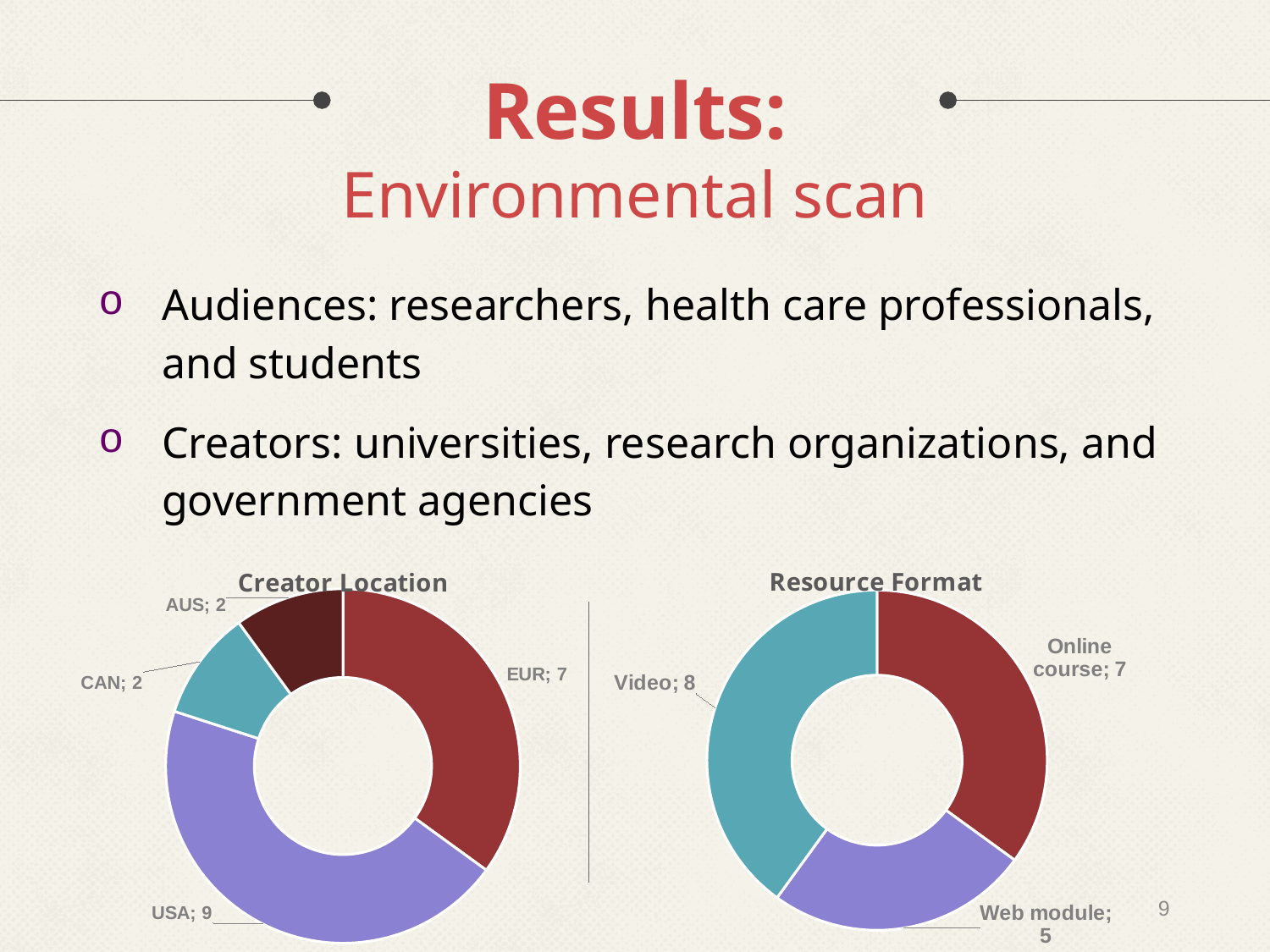
In the Resource Format chart, what is the value for Video? 8 In the Creator Location chart, how many location categories are shown? 4 In the Creator Location chart, what share of the total does USA represent? 45% In the Creator Location chart, what is the difference between the values for USA and EUR? 2 In the Creator Location chart, what is the value for EUR? 7 In the Resource Format chart, which is larger, Video or Online course? Video In the Creator Location chart, which location has the highest value? USA In the Resource Format chart, what is the value for Web module? 5 In the Resource Format chart, what share of the total does Video represent? 40% What kind of chart is the Resource Format chart? Doughnut chart In the Creator Location chart, what is the value for USA? 9 In the Resource Format chart, which format has the lowest value? Web module